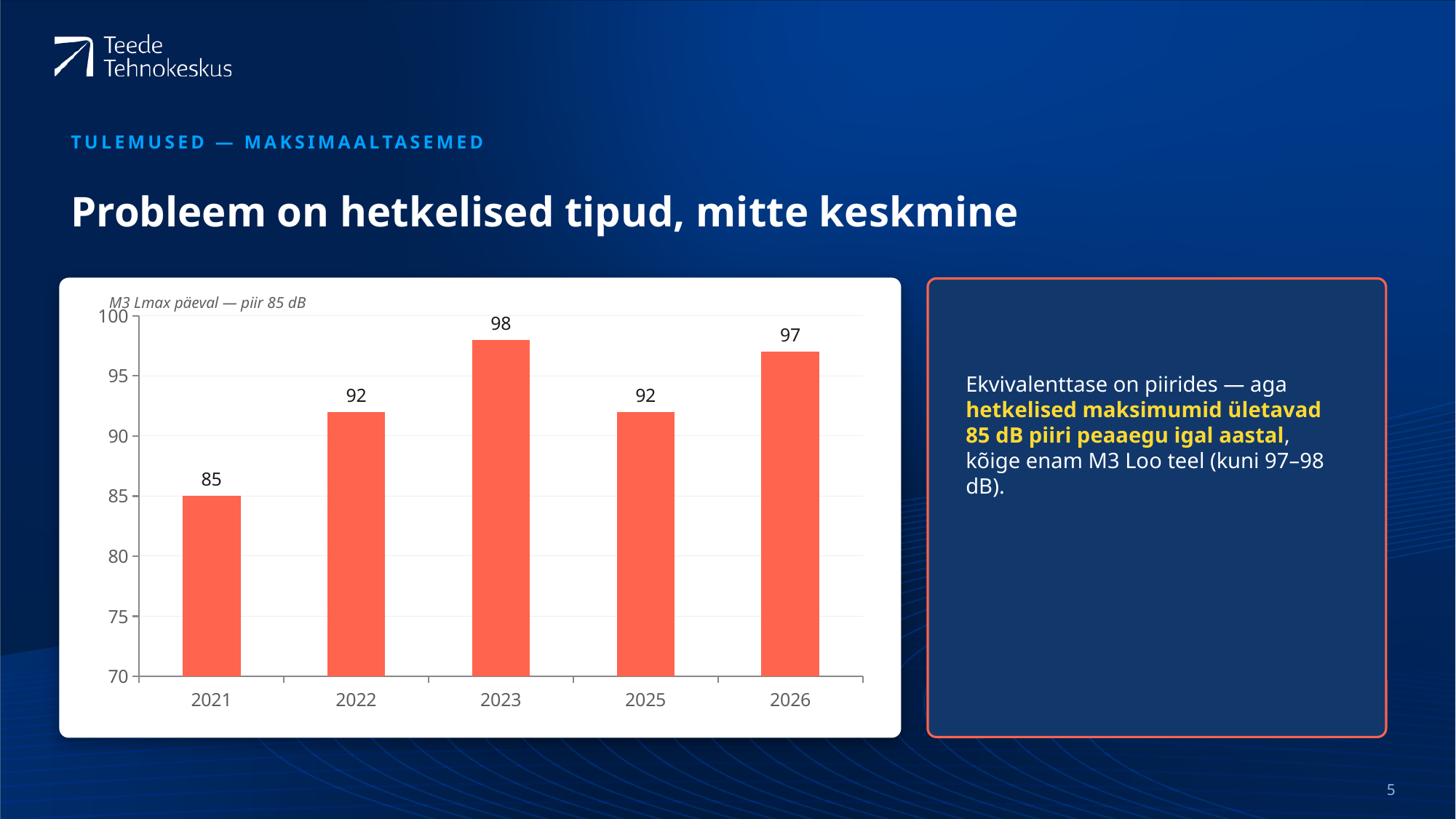
What is the value for 2021? 85 What kind of chart is shown on the slide? bar chart What is the value for 2026? 97 What is the difference between the values for 2023 and 2021? 13 How many years are shown on the x axis? 5 Is the value for 2022 greater or less than 90? greater Which year has the highest value? 2023 Which is larger, the value for 2026 or the value for 2025? 2026 What colour are the bars in the chart? red-orange Which year has the lowest value? 2021 What is the value for 2023? 98 What is the title of the chart? M3 Lmax päeval — piir 85 dB